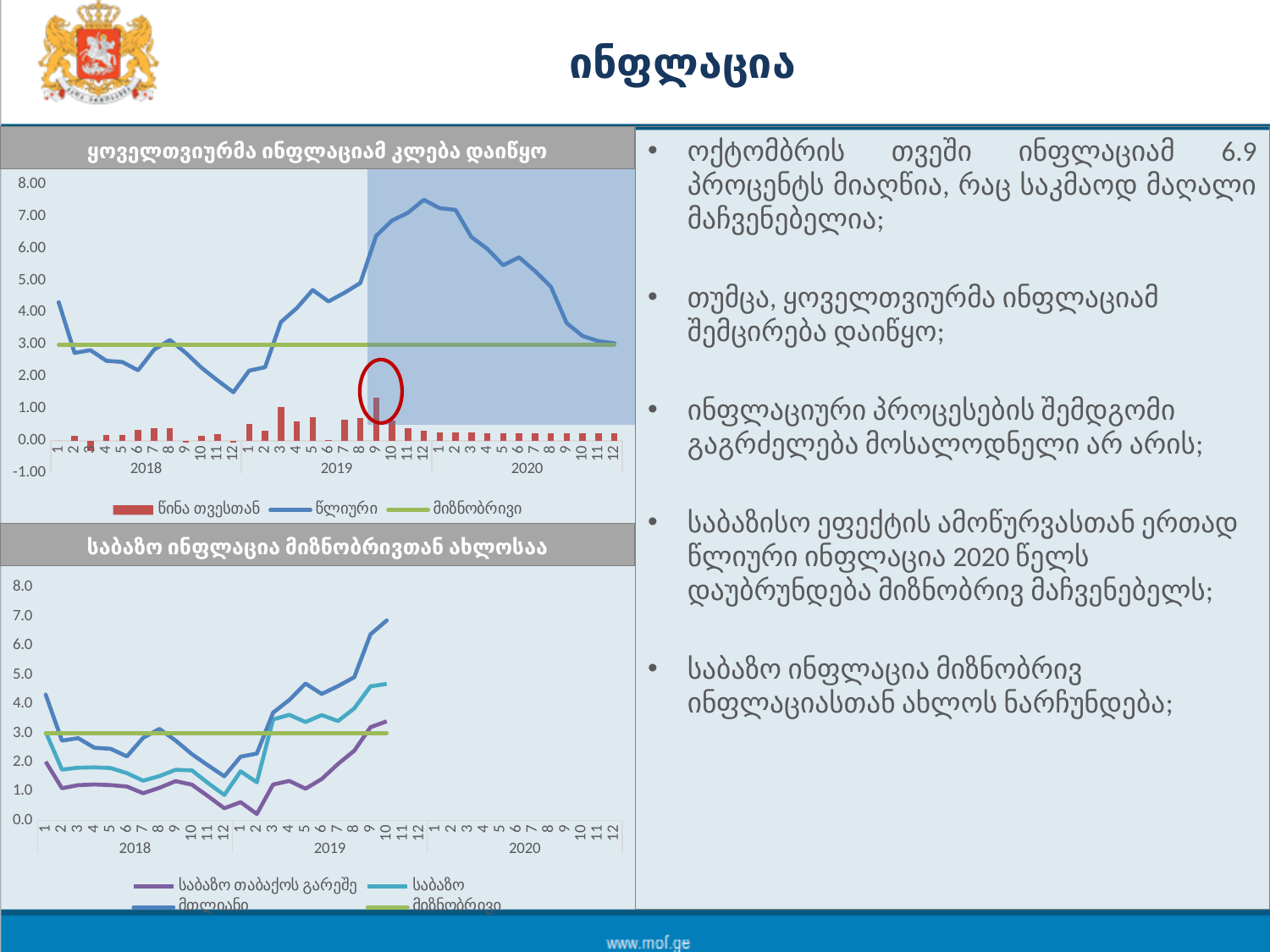
In the top chart, is the value of the წლიური line at month 12 of 2019 greater or less than 7.00? greater How many series does the legend of the bottom chart titled "საბაზო ინფლაცია მიზნობრივთან ახლოსაა" list? 4 In the bottom chart, is the value of the საბაზო თაბაქოს გარეშე line at month 2 of 2019 greater or less than 1.0? less What kind of chart is the top chart titled "ყოველთვიურმა ინფლაციამ კლება დაიწყო"? A combined bar and line chart In the top chart, at which month and year does the წლიური line reach its highest point? Month 12 of 2019 In the bottom chart, is the value of the მთლიანი line at month 10 of 2019 greater or less than 6.0? greater How many series does the legend of the top chart list? 3 In the top chart, which series is drawn as bars? წინა თვესთან In the top chart, which is larger: the წლიური value at month 12 of 2019 or at month 12 of 2018? Month 12 of 2019 In the top chart, does the წლიური line rise or fall across the months of 2020? Fall In the bottom chart, which series has the highest value at month 10 of 2019? მთლიანი